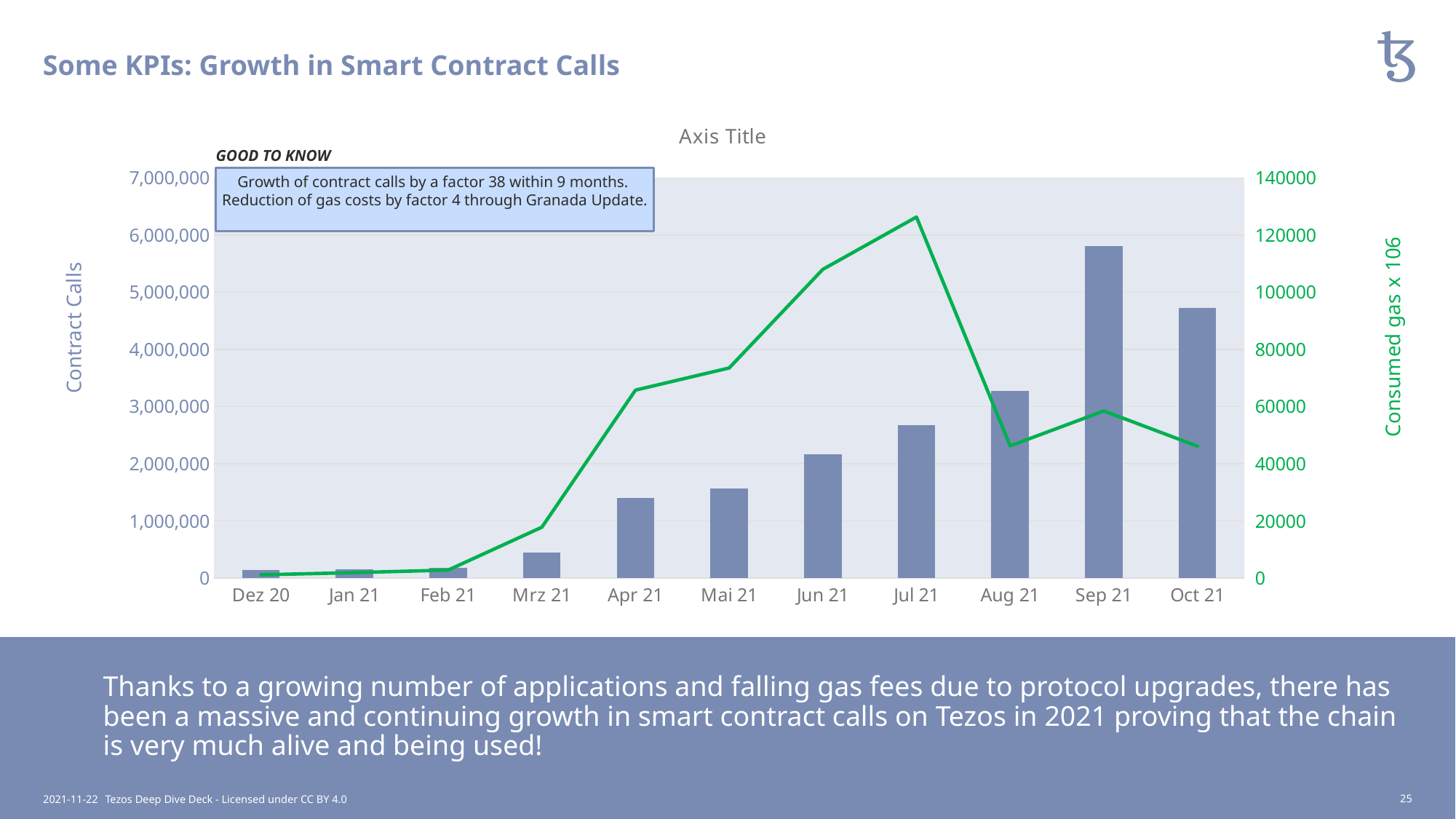
What kind of chart is shown on the slide? A combined bar and line chart Is the Consumed gas value for Aug 21 greater or less than 60000? less Is the Contract Calls value for Mrz 21 greater or less than 1,000,000? less Is the Contract Calls value for Sep 21 greater or less than 5,000,000? greater Which month has the highest bar for Contract Calls? Sep 21 How many months are shown on the x axis of the chart? 11 In which month does the Consumed gas line reach its peak? Jul 21 Which month has the larger Contract Calls bar, Sep 21 or Oct 21? Sep 21 What is the title of the left vertical axis? Contract Calls